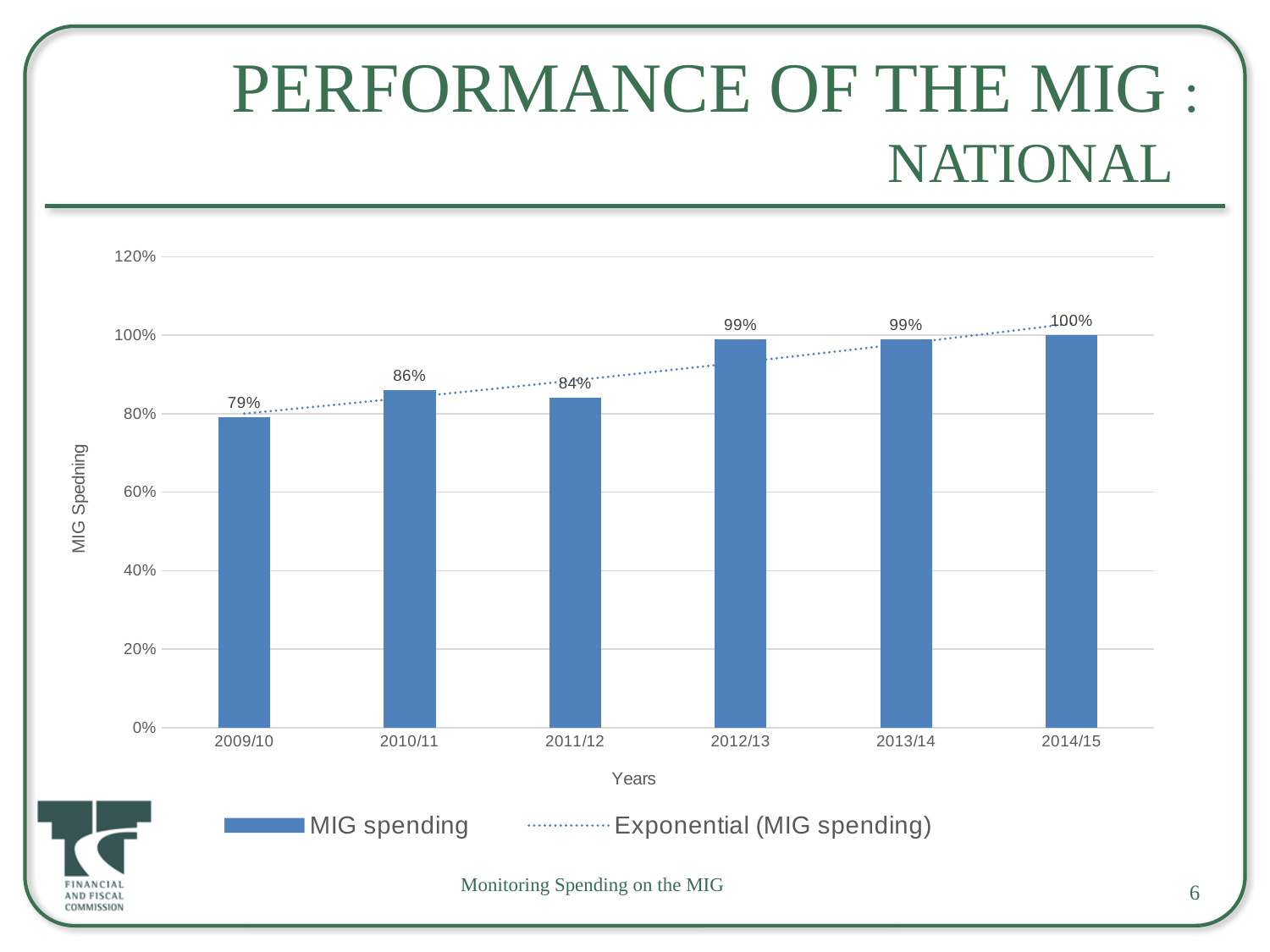
How many entries does the legend list? 2 Which year has the lowest MIG spending? 2009/10 What is the MIG spending value for 2009/10? 79% What is the difference in MIG spending between 2012/13 and 2011/12? 15% What is the label of the y axis? MIG Spedning What is the difference in MIG spending between 2010/11 and 2009/10? 7% What is the MIG spending value for 2014/15? 100% Which year has higher MIG spending, 2010/11 or 2011/12? 2010/11 How many years are shown on the x axis? 6 What is the MIG spending value for 2011/12? 84% What kind of chart is shown on the slide? Bar chart Which year has the highest MIG spending? 2014/15